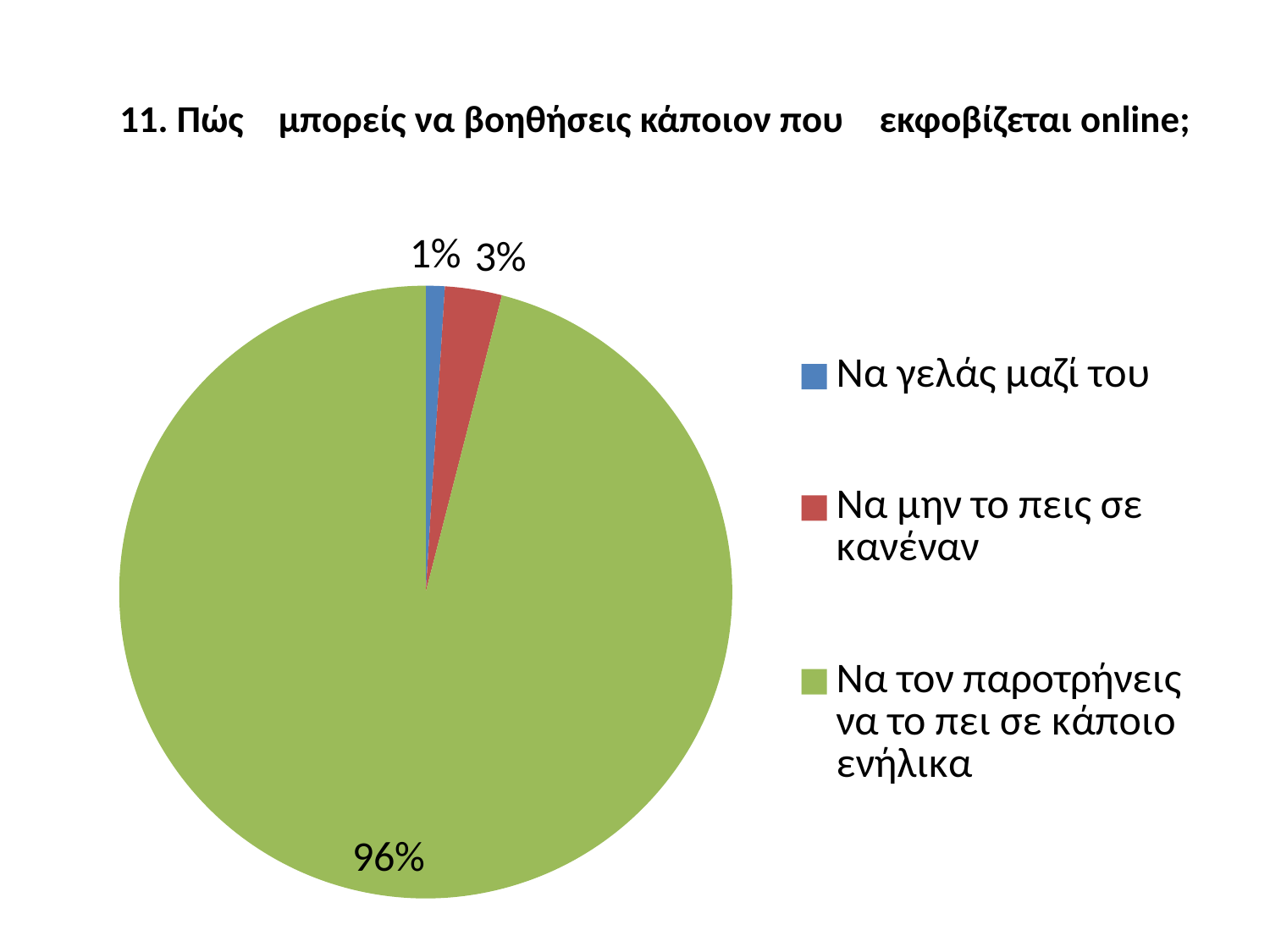
What colour is the slice for "Να τον παροτρήνεις να το πει σε κάποιο ενήλικα"? green Which category has the smallest slice of the pie? Να γελάς μαζί του What kind of chart is shown on the slide? pie chart What is the difference in percentage points between "Να μην το πεις σε κανέναν" and "Να γελάς μαζί του"? 2 What is the title of the chart? 11. Πώς μπορείς να βοηθήσεις κάποιον που εκφοβίζεται online; What share of the pie does "Να γελάς μαζί του" have? 1% How many entries does the legend list? 3 What share of the pie does "Να τον παροτρήνεις να το πει σε κάποιο ενήλικα" have? 96% How many slices does the pie chart have? 3 What share of the pie does "Να μην το πεις σε κανέναν" have? 3% Which is larger: the slice for "Να μην το πεις σε κανέναν" or the slice for "Να γελάς μαζί του"? Να μην το πεις σε κανέναν Which category has the largest slice of the pie? Να τον παροτρήνεις να το πει σε κάποιο ενήλικα